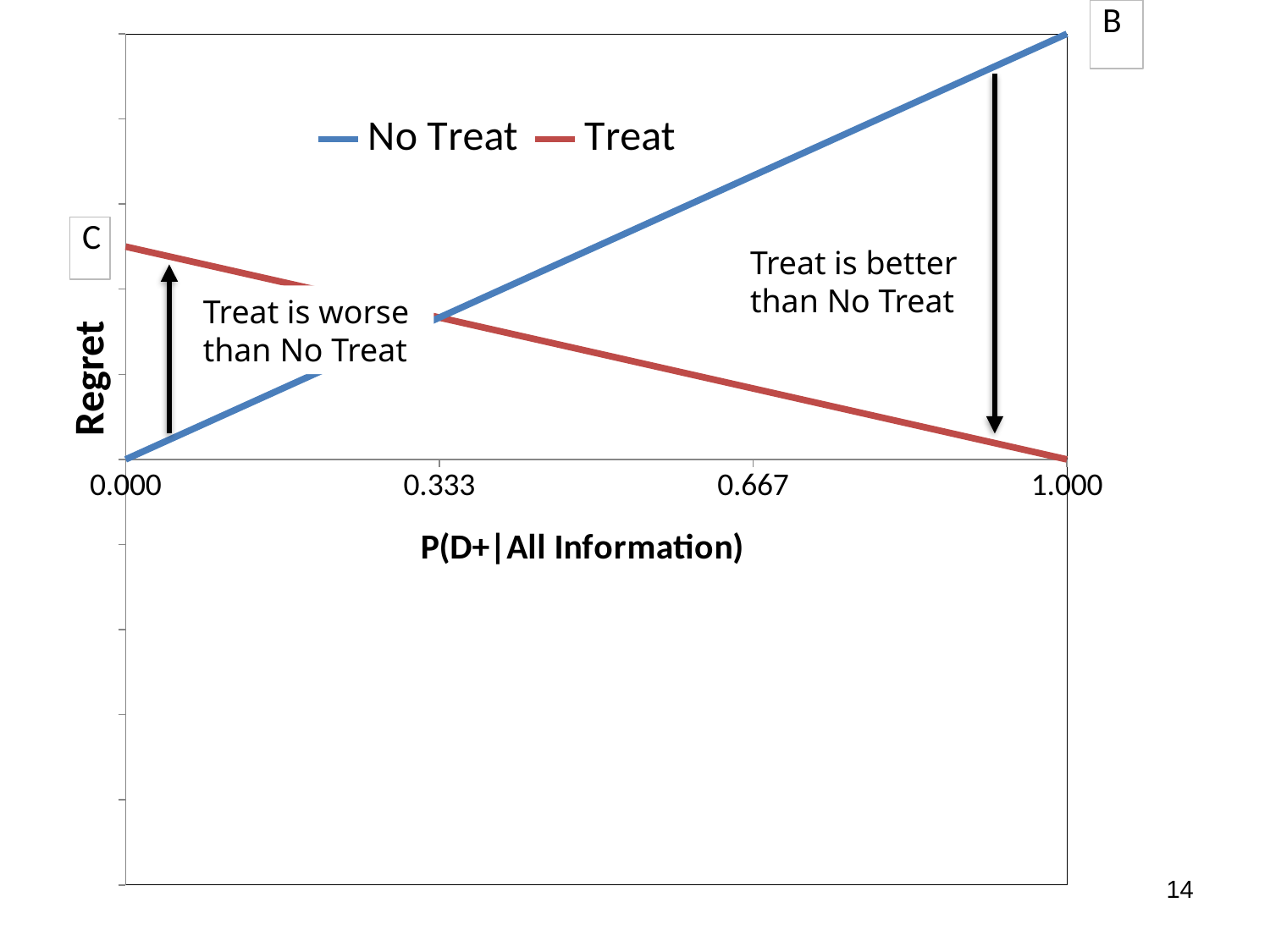
What is the title of the x axis? P(D+|All Information) What are the two series named in the legend? No Treat and Treat At P(D+|All Information) = 0.000, which series has the higher regret, No Treat or Treat? Treat Which series reaches the highest regret anywhere on the chart? No Treat Does the Treat line rise or fall as P(D+|All Information) increases? falls How many labelled tick values are shown on the x axis? 4 What kind of chart is shown on the slide? line chart At what value of P(D+|All Information) do the No Treat and Treat lines cross? 0.333 At P(D+|All Information) = 1.000, which series has the higher regret, No Treat or Treat? No Treat How many series does the legend list? 2 Does the No Treat line rise or fall as P(D+|All Information) increases? rises